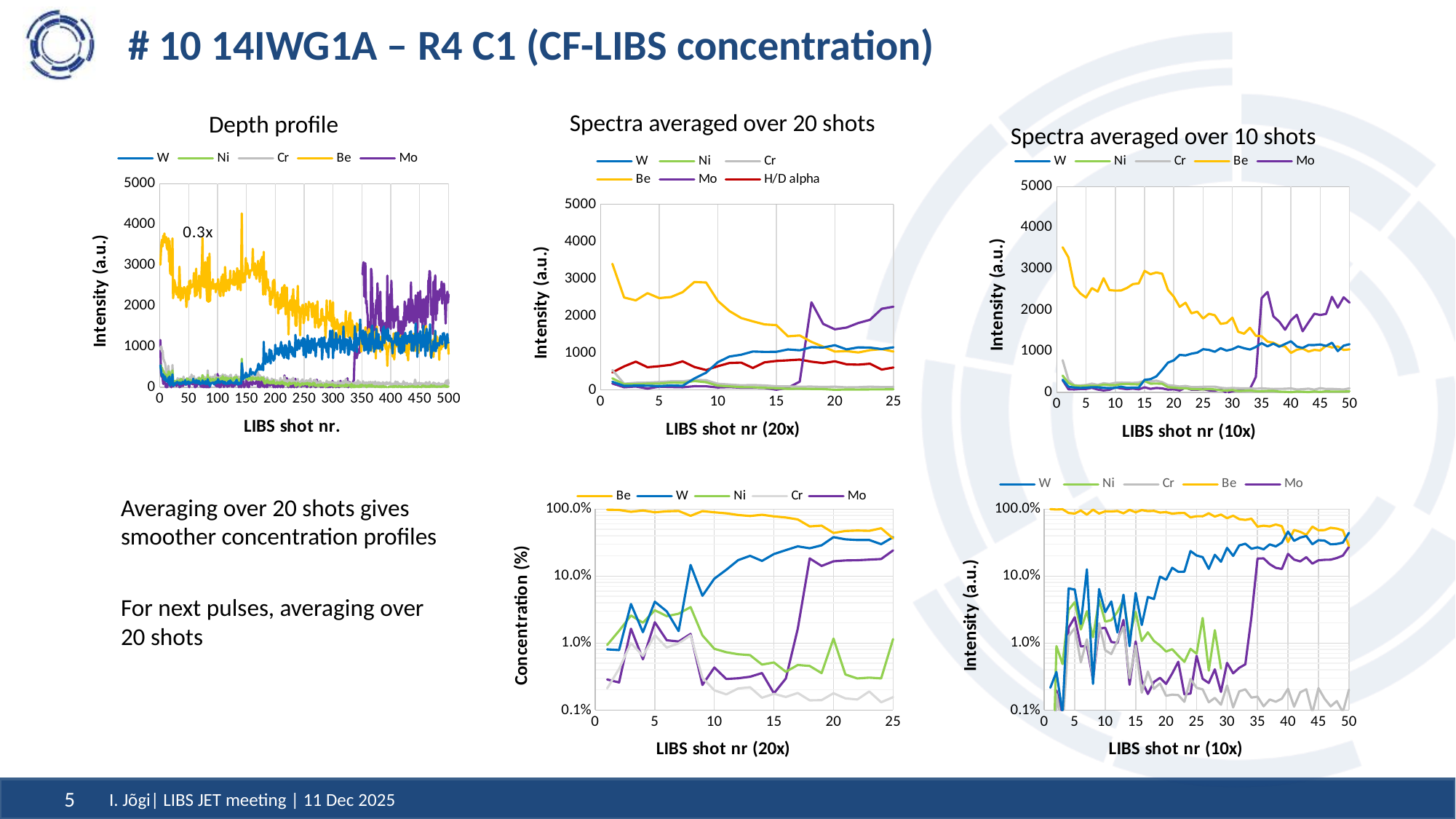
In the Spectra averaged over 20 shots chart, does the Be series rise or fall along the x axis? Fall In the Spectra averaged over 20 shots chart, does the W series rise or fall along the x axis? Rise In the Spectra averaged over 20 shots chart, at shot 5, which is larger: Be or W? Be In the Spectra averaged over 20 shots chart, which series has the highest value at shot 1? Be In the Spectra averaged over 10 shots chart, is the Mo value at shot 10 greater or less than 500? less In the bottom-middle chart, is the Cr value at shot 20 greater or less than 1.0%? less What is the y-axis title of the bottom-middle chart? Concentration (%) In the Spectra averaged over 20 shots chart, how many series does the legend list? 6 In the Depth profile chart, how many series does the legend list? 5 What annotation text appears near the Be line in the Depth profile chart? 0.3x What kind of chart is the Spectra averaged over 10 shots chart? Line chart In the Spectra averaged over 20 shots chart, is the Be value at shot 1 greater or less than 3000? greater